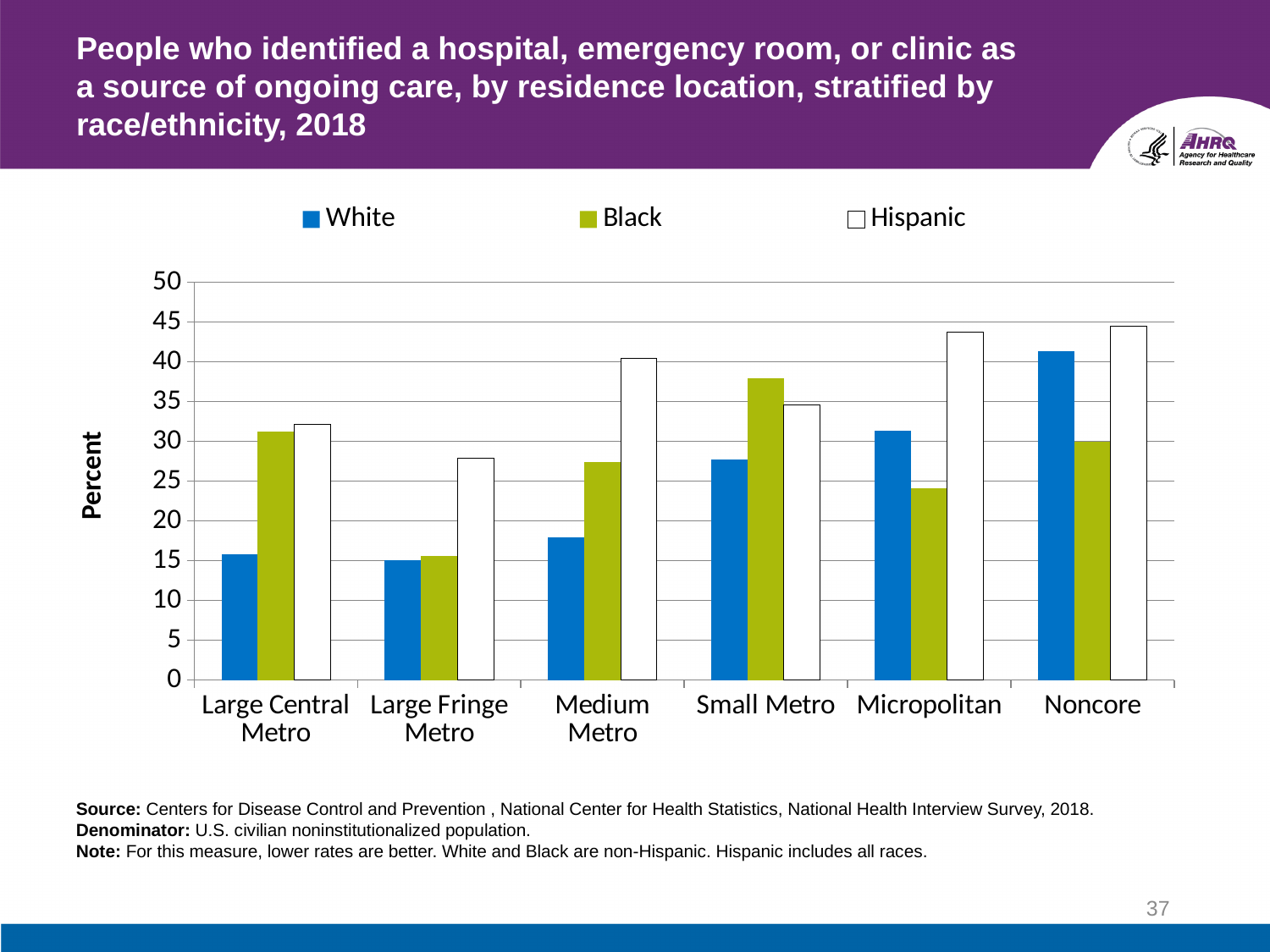
Is the value for Hispanic in Large Fringe Metro greater or less than 30? less In Micropolitan, which is larger, the value for White or the value for Black? White In Small Metro, which is larger, the value for Black or the value for Hispanic? Black Is the value for White in Large Central Metro greater or less than 20? less What is the label on the vertical axis? Percent How many residence location categories are shown on the x axis? 6 Which residence location has the highest value for White? Noncore What kind of chart is shown on the slide? bar chart Which residence location has the lowest value for Hispanic? Large Fringe Metro Is the value for Hispanic in Micropolitan greater or less than 40? greater How many series does the legend list? 3 Which residence location has the highest value for Black? Small Metro